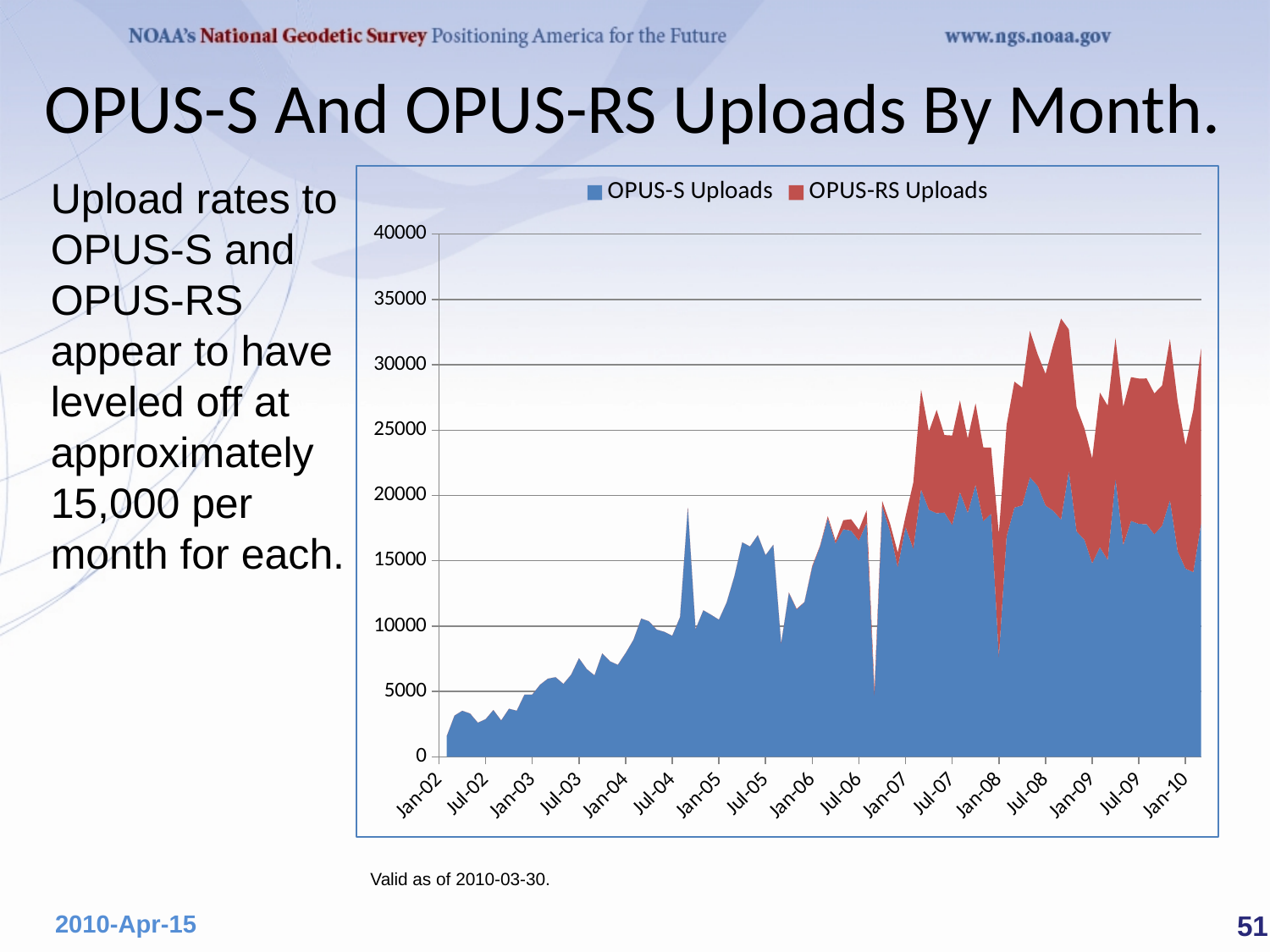
How many date labels are shown along the chart's horizontal axis? 17 What is the highest value shown on the chart's vertical axis? 40000 Does the combined total of uploads ever exceed 35000 on the chart? No Is the value for OPUS-S Uploads at Jan-02 greater or less than 5000? less Is the value for OPUS-S Uploads at Jan-05 greater or less than 5000? greater How many series does the chart legend list? 2 At Jan-07, which series has the larger value, OPUS-S Uploads or OPUS-RS Uploads? OPUS-S Uploads Overall, do OPUS-S Uploads rise or fall from Jan-02 to Jan-10? Rise What type of chart is shown on the slide? Stacked area chart What are the two series named in the chart legend? OPUS-S Uploads and OPUS-RS Uploads Which colour represents OPUS-RS Uploads in the chart? Red